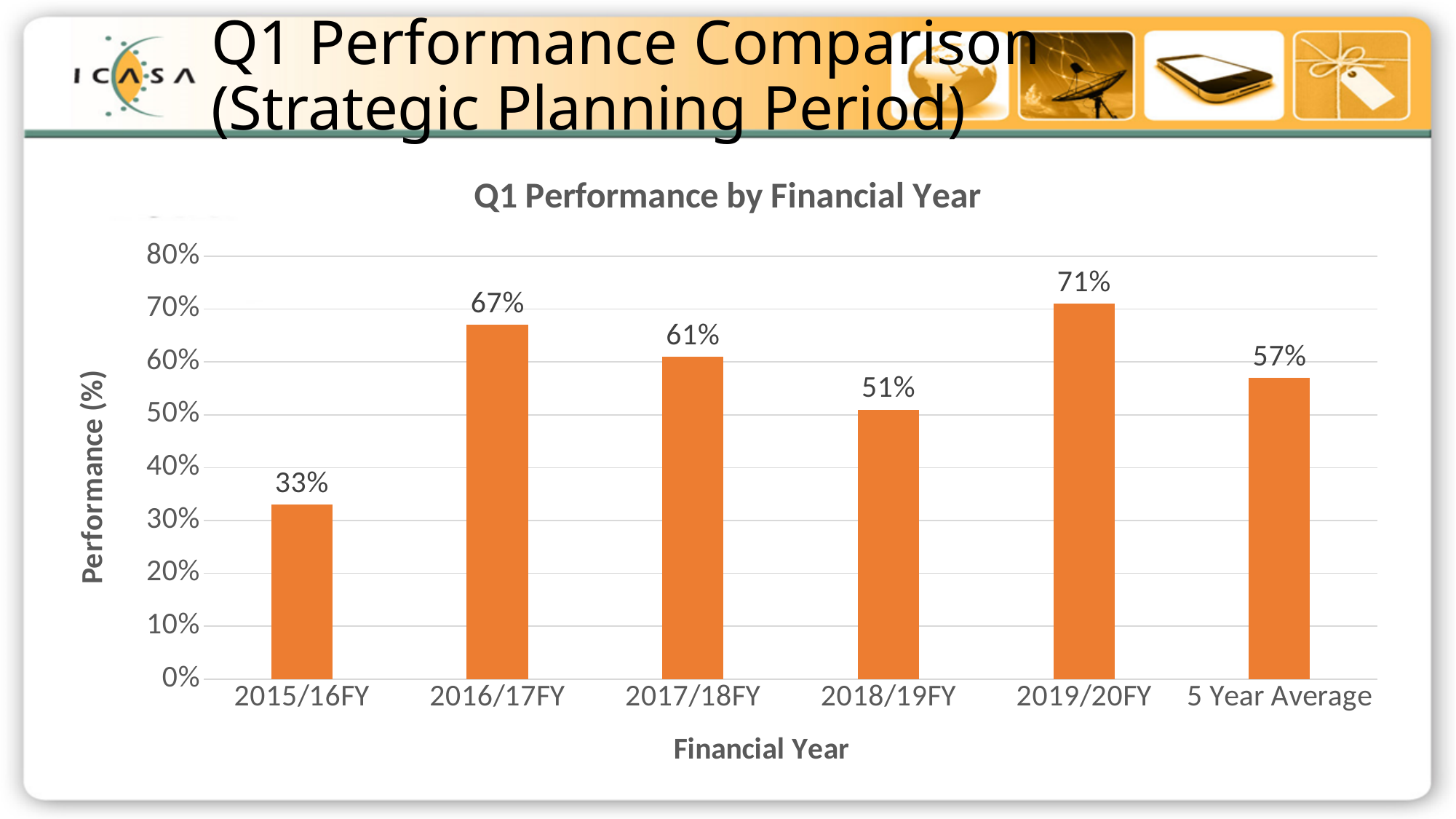
What is the difference between the Q1 performance for 2016/17FY and 2017/18FY? 6% Is the value for 2018/19FY greater or less than 60%? less Which financial year has the highest Q1 performance? 2019/20FY What is the title of the chart? Q1 Performance by Financial Year What is the value shown for the 5 Year Average? 57% Which financial year has the lowest Q1 performance? 2015/16FY What is the difference between the Q1 performance for 2019/20FY and 2015/16FY? 38% What is the Q1 performance value for 2018/19FY? 51% What kind of chart is shown on the slide? Bar chart What is the Q1 performance value for 2015/16FY? 33% How many bars are shown in the chart? 6 Which has a higher Q1 performance, 2017/18FY or 2018/19FY? 2017/18FY